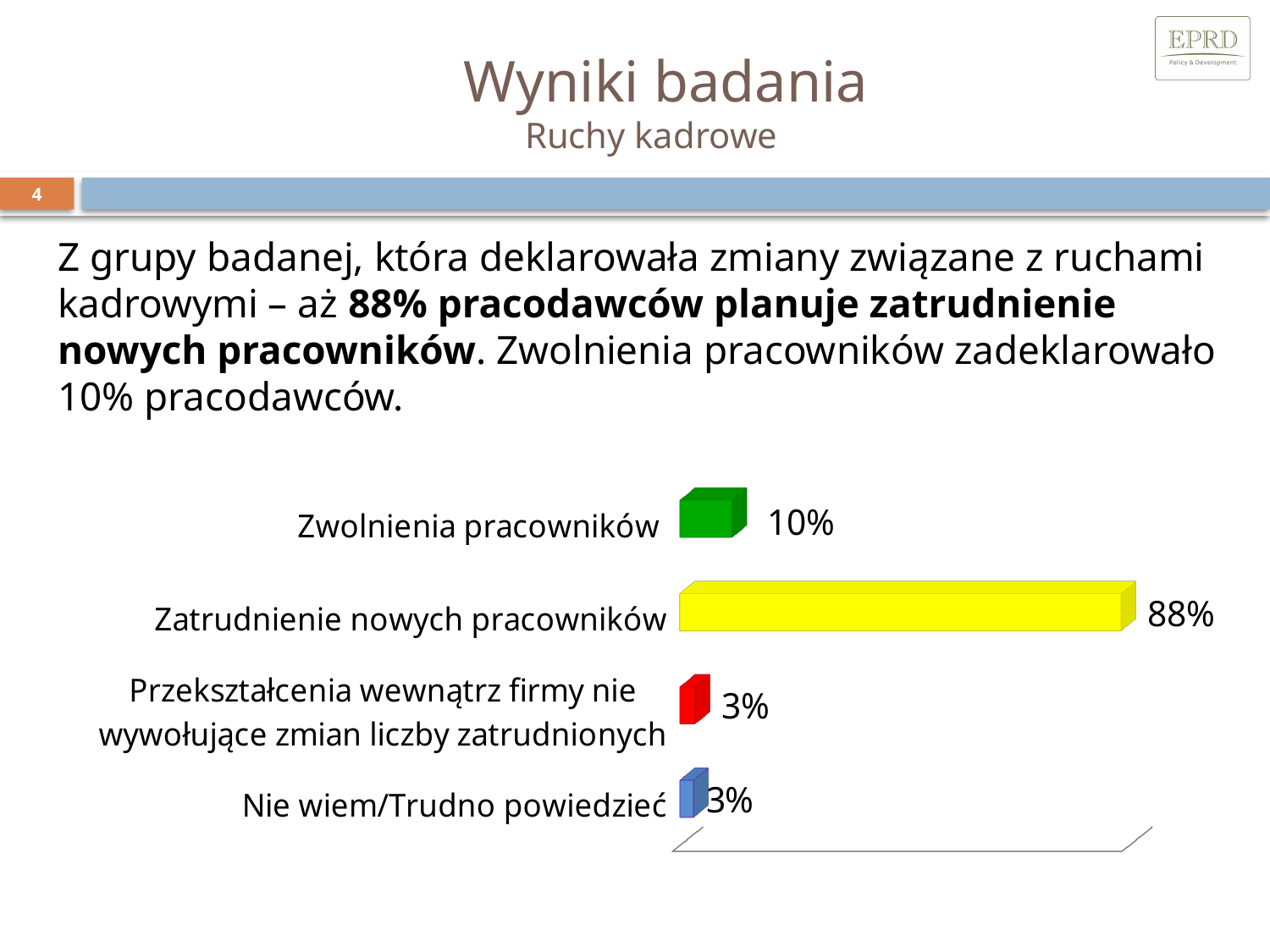
What is the value for Przekształcenia wewnątrz firmy nie wywołujące zmian liczby zatrudnionych? 3% Which is larger, the value for Zwolnienia pracowników or the value for Zatrudnienie nowych pracowników? Zatrudnienie nowych pracowników What is the difference between the values for Zwolnienia pracowników and Nie wiem/Trudno powiedzieć? 7% What colour is the bar for Zwolnienia pracowników? Green How many categories are shown in the chart? 4 What is the value for Nie wiem/Trudno powiedzieć? 3% What kind of chart is shown on the slide? Bar chart What is the value for Zwolnienia pracowników? 10% What is the value for Zatrudnienie nowych pracowników? 88% Which category has the highest value? Zatrudnienie nowych pracowników What is the difference between the values for Zatrudnienie nowych pracowników and Zwolnienia pracowników? 78% What colour is the bar for Zatrudnienie nowych pracowników? Yellow